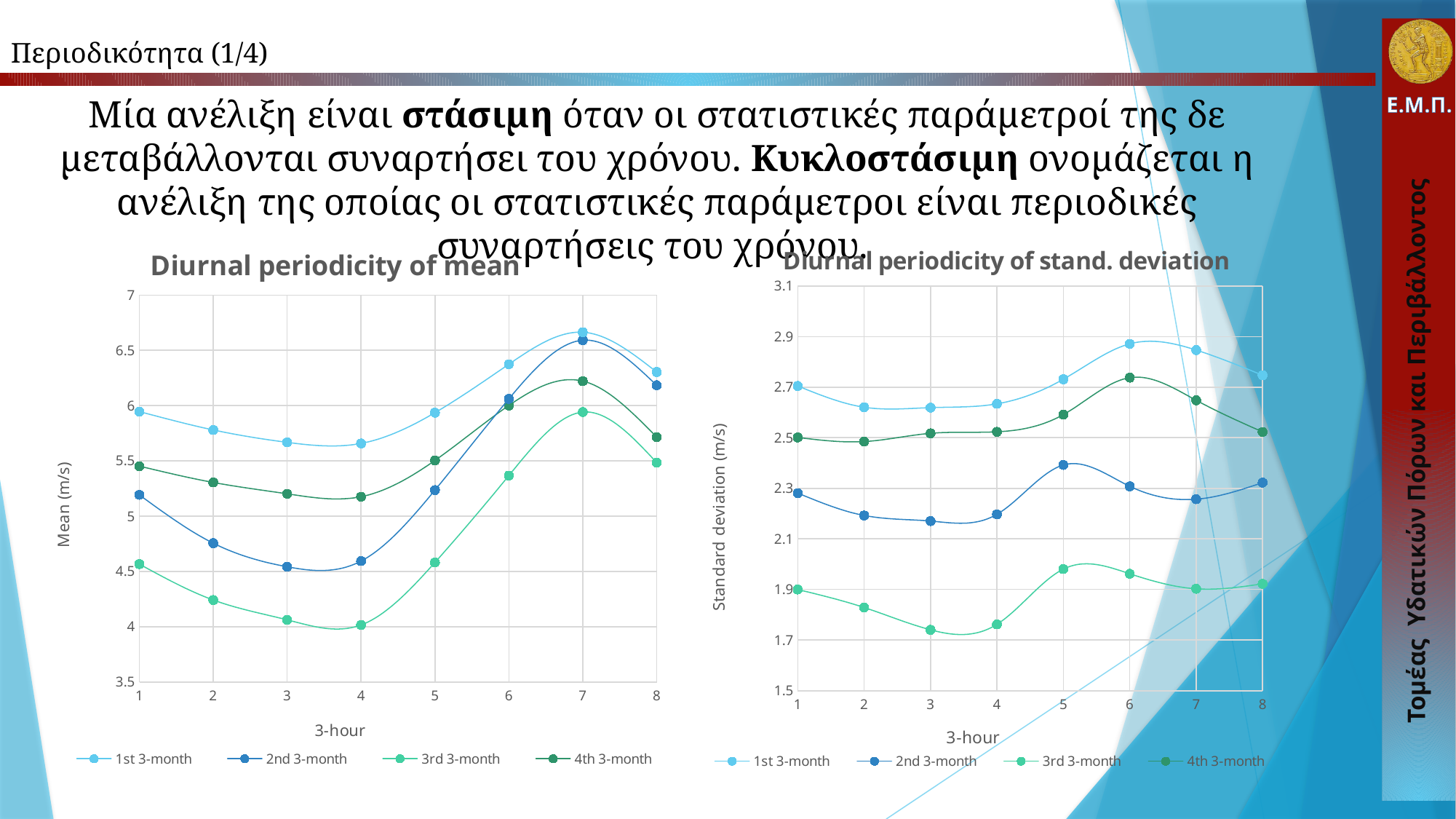
In the 'Diurnal periodicity of mean' chart, at 3-hour 1, which is higher: the 4th 3-month series or the 2nd 3-month series? 4th 3-month How many series does the legend of the 'Diurnal periodicity of mean' chart list? 4 In the 'Diurnal periodicity of mean' chart, is the value of the 1st 3-month series at 3-hour 6 greater or less than 6? greater In the 'Diurnal periodicity of stand. deviation' chart, which series has the highest value at 3-hour 1? 1st 3-month In the 'Diurnal periodicity of mean' chart, does the 3rd 3-month series rise or fall from 3-hour 1 to 3-hour 4? fall What kind of chart is the 'Diurnal periodicity of mean' chart? line chart In the 'Diurnal periodicity of stand. deviation' chart, which series has the lowest value at 3-hour 3? 3rd 3-month How many 3-hour points are plotted along the x axis of the 'Diurnal periodicity of stand. deviation' chart? 8 In the 'Diurnal periodicity of mean' chart, is the value of the 3rd 3-month series at 3-hour 1 greater or less than 5? less In the 'Diurnal periodicity of stand. deviation' chart, is the value of the 1st 3-month series at 3-hour 6 greater or less than 2.7? greater In the 'Diurnal periodicity of mean' chart, which series has the lowest value at 3-hour 4? 3rd 3-month What is the y-axis label of the 'Diurnal periodicity of stand. deviation' chart? Standard deviation (m/s)